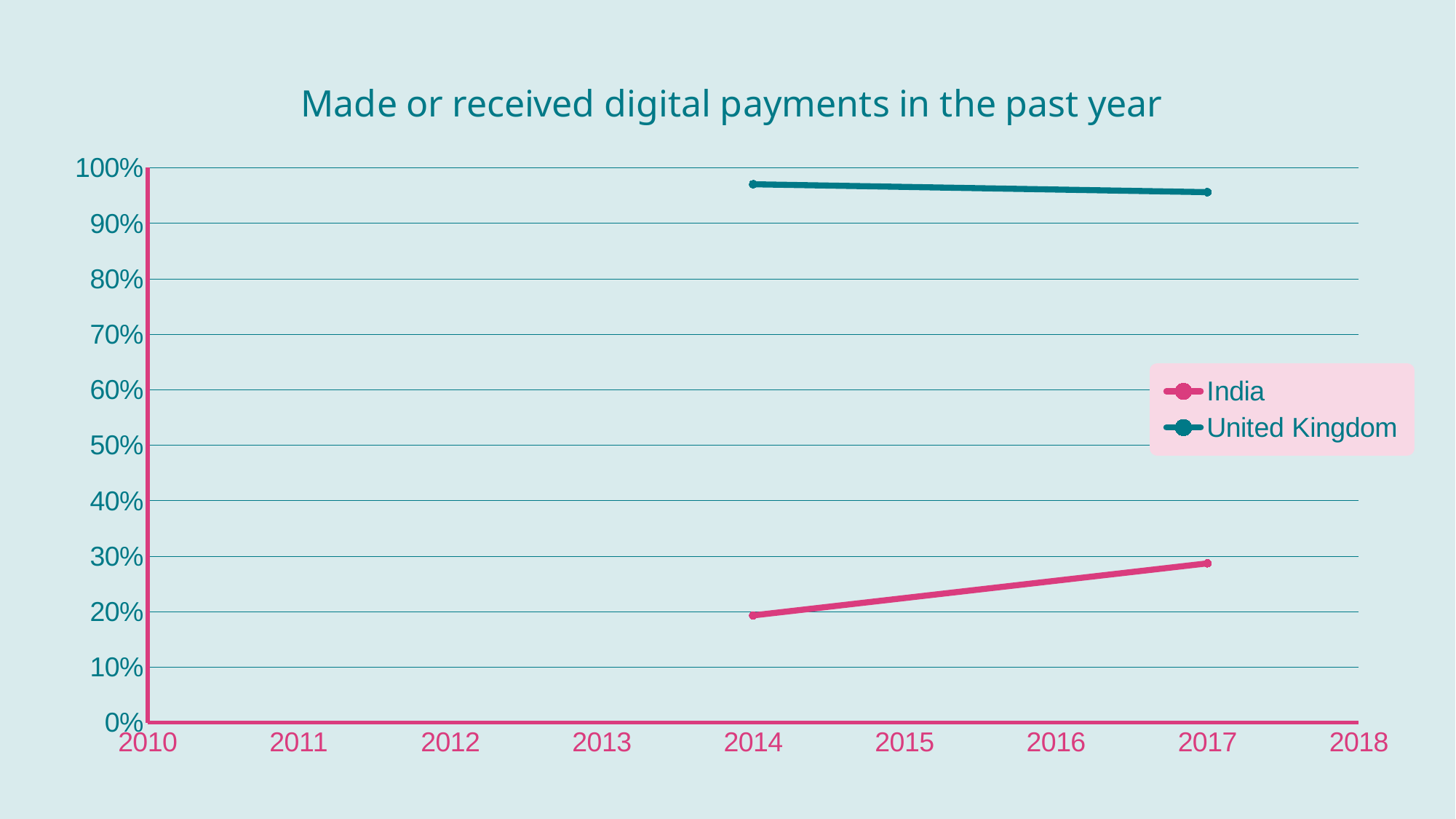
Is the value for India in 2017 greater or less than 20%? greater Is the value for United Kingdom in 2017 greater or less than 100%? less What kind of chart is shown on the slide? line chart Which series has the higher value in 2017, India or United Kingdom? United Kingdom Does the India line rise or fall from 2014 to 2017? rise What is the title of the chart? Made or received digital payments in the past year How many data points are plotted for the India series? 2 Which two series are listed in the legend? India and United Kingdom Is the value for India in 2014 greater or less than 10%? greater Which series has the lowest value on the chart? India How many series does the legend list? 2